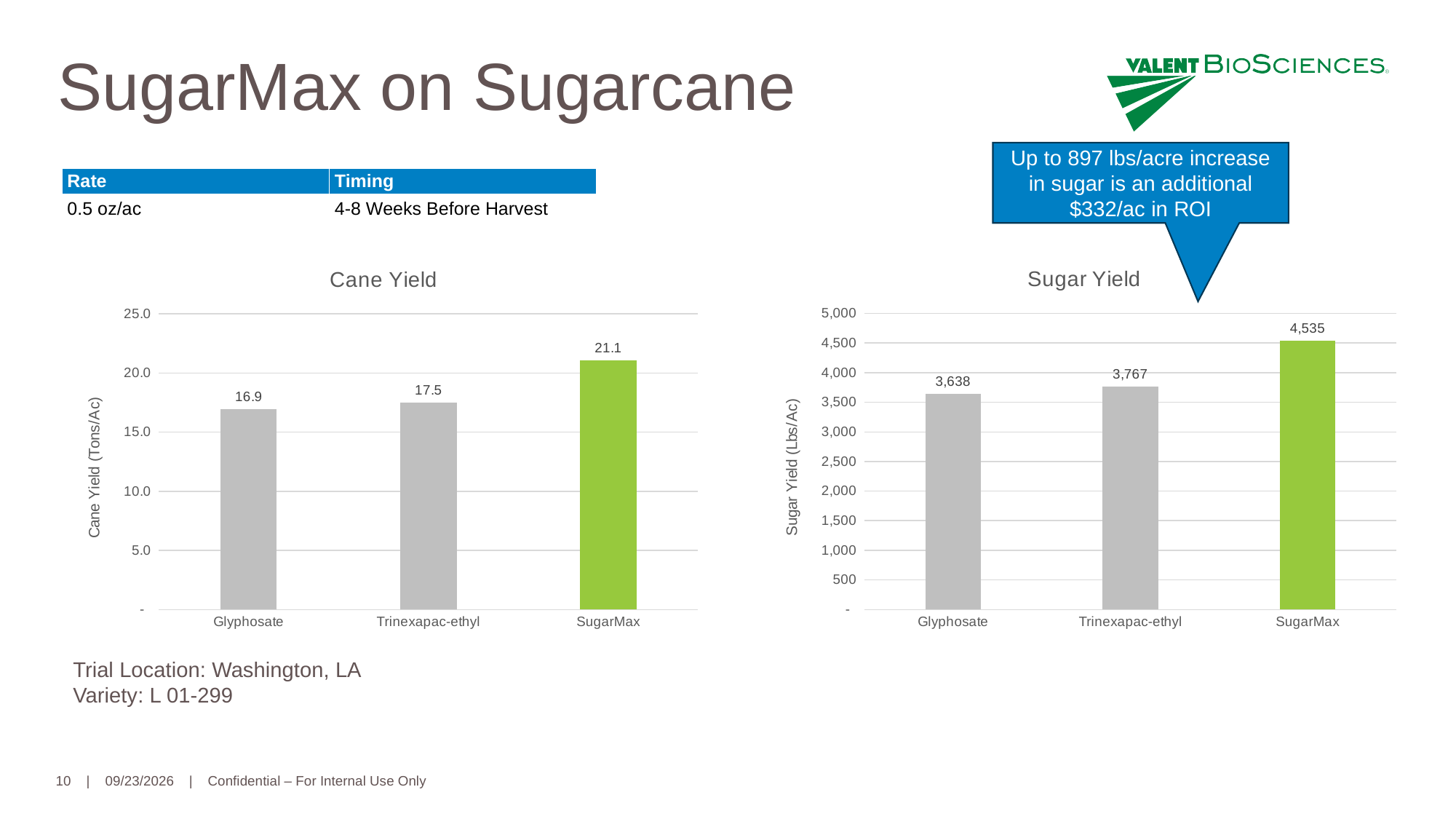
In the Sugar Yield chart, what is the difference between SugarMax and Glyphosate? 897 In the Sugar Yield chart, what is the value for SugarMax? 4,535 In the Sugar Yield chart, what is the value for Trinexapac-ethyl? 3,767 In the Cane Yield chart, what is the difference between SugarMax and Trinexapac-ethyl? 3.6 In the Sugar Yield chart, which category has the lowest value? Glyphosate What kind of chart is the Sugar Yield chart? bar chart In the Cane Yield chart, which is larger, Glyphosate or Trinexapac-ethyl? Trinexapac-ethyl In the Cane Yield chart, what is the value for Glyphosate? 16.9 How many categories are shown in the Cane Yield chart? 3 In the Cane Yield chart, which category has the highest value? SugarMax In the Cane Yield chart, what is the value for SugarMax? 21.1 In the Sugar Yield chart, is the value for SugarMax greater or less than 4,000? greater